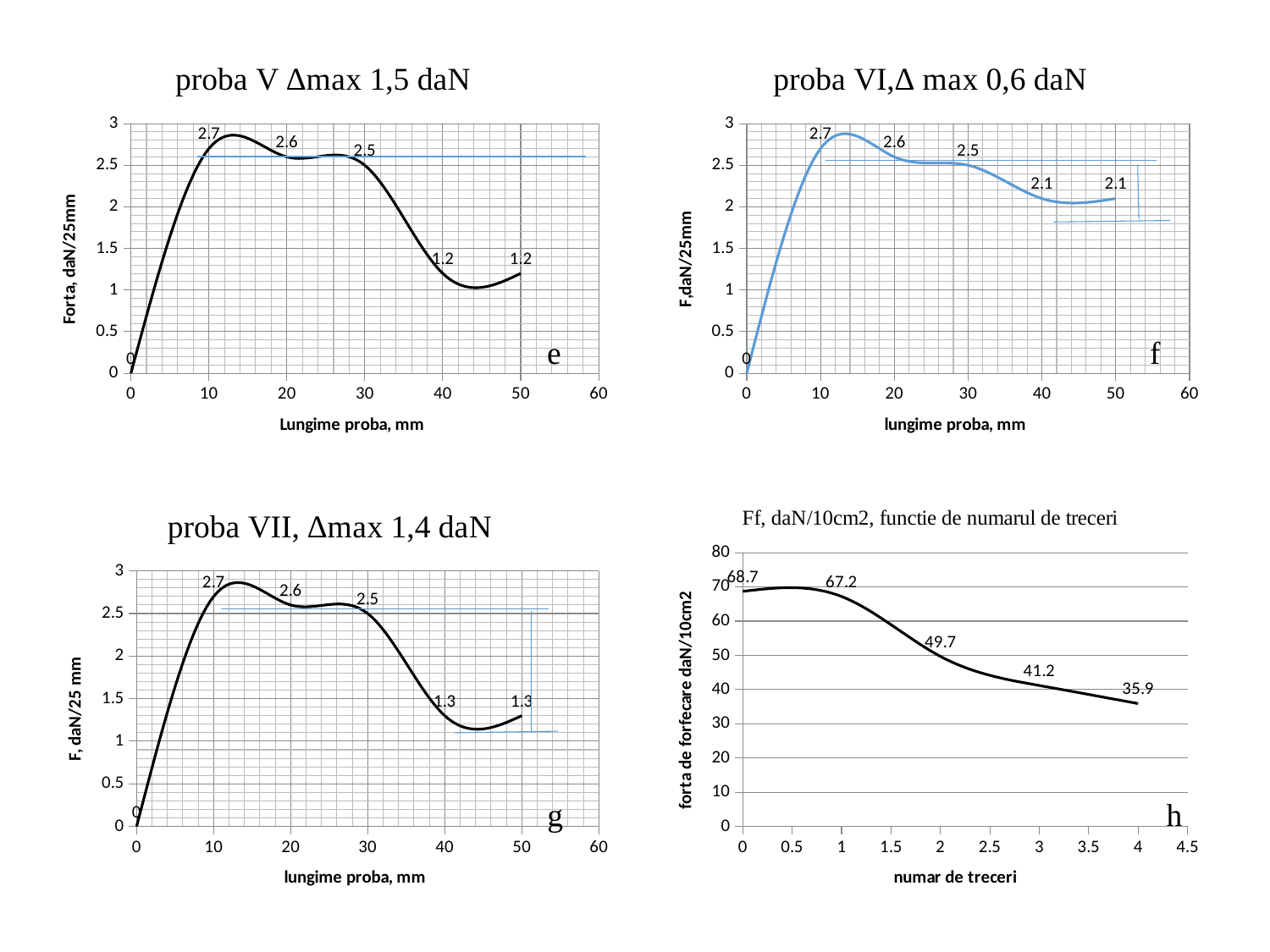
In the chart titled "proba VII, Δmax 1,4 daN", what is the data label at a sample length of 40 mm? 1.3 What type of chart is the chart titled "proba V Δmax 1,5 daN"? line chart In the chart titled "proba V Δmax 1,5 daN", what is the data label at a sample length of 10 mm? 2.7 In the chart titled "proba VI,Δ max 0,6 daN", what is the data label at a sample length of 50 mm? 2.1 In the chart titled "Ff, daN/10cm2, functie de numarul de treceri", what is the difference between the values at 0 passes and 4 passes? 32.8 In the chart titled "proba VI,Δ max 0,6 daN", what is the difference between the labelled values at 10 mm and 40 mm? 0.6 Which is larger: the value at 40 mm in the chart "proba VI,Δ max 0,6 daN" or the value at 40 mm in the chart "proba VII, Δmax 1,4 daN"? proba VI,Δ max 0,6 daN In the chart titled "Ff, daN/10cm2, functie de numarul de treceri", what is the value at 2 passes (numar de treceri = 2)? 49.7 In the chart titled "proba V Δmax 1,5 daN", what is the data label at a sample length of 40 mm? 1.2 In the chart titled "Ff, daN/10cm2, functie de numarul de treceri", do the values rise or fall as the number of passes increases? fall In the chart titled "Ff, daN/10cm2, functie de numarul de treceri", how many labelled data points are there? 5 In the chart titled "Ff, daN/10cm2, functie de numarul de treceri", at which number of passes is the value lowest? 4